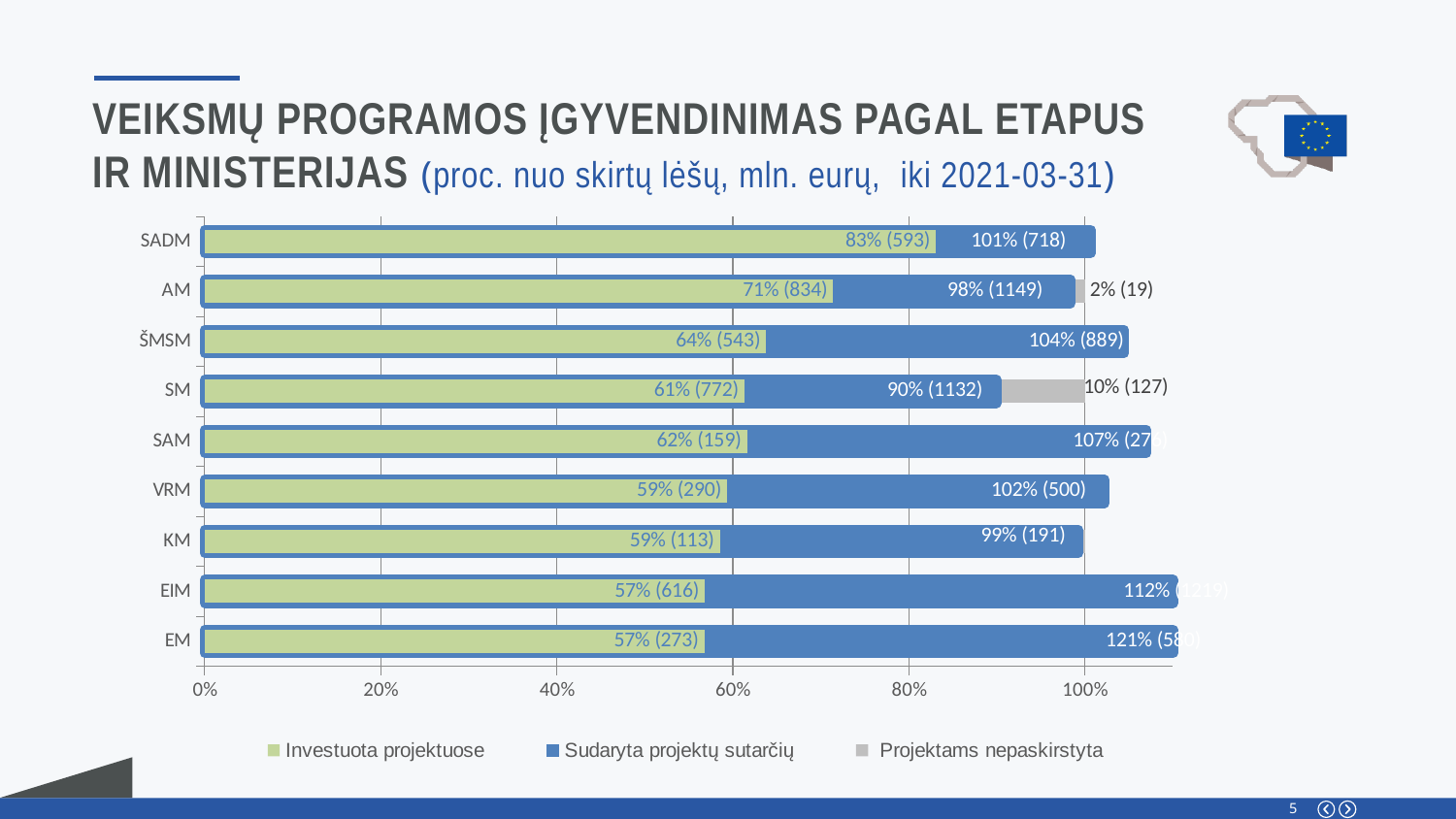
Which ministry has the highest 'Investuota projektuose' percentage? SADM What is the 'Investuota projektuose' value for SADM? 83% (593) Is the 'Sudaryta projektų sutarčių' value for SM greater or less than 100%? less What is the 'Sudaryta projektų sutarčių' value for VRM? 102% (500) Which ministry has the lowest 'Sudaryta projektų sutarčių' percentage? SM How many ministries are shown on the chart? 9 What is the 'Projektams nepaskirstyta' value for SM? 10% (127) What is the 'Sudaryta projektų sutarčių' value for AM? 98% (1149) What is the difference in percentage points between the 'Investuota projektuose' values for SADM and AM? 12 What kind of chart is shown on the slide? bar chart Which is larger, the 'Investuota projektuose' percentage for ŠMSM or for KM? ŠMSM How many series does the legend list? 3